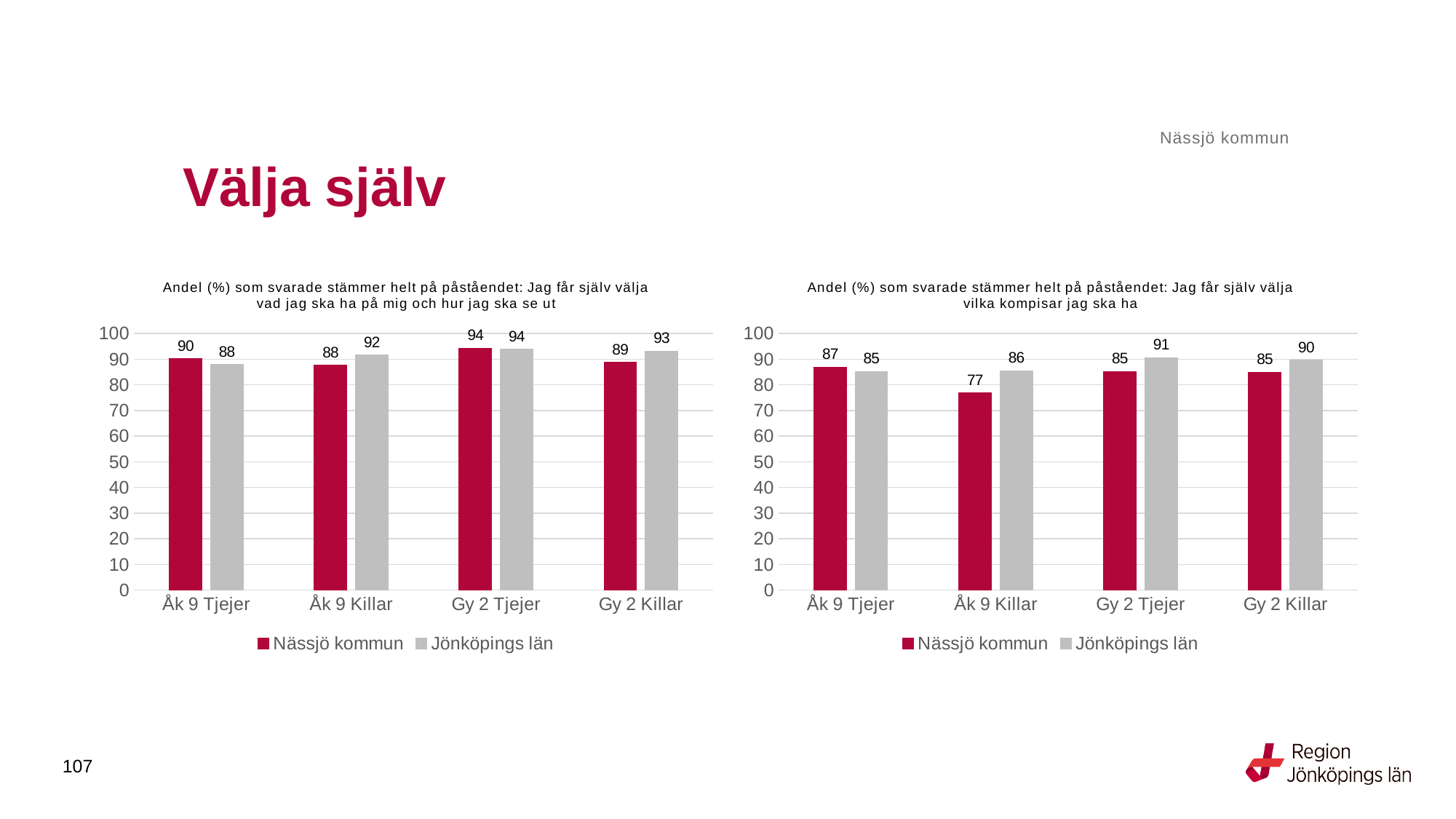
What type of chart is the right chart? Bar chart In the right chart, what is the value for Jönköpings län for Gy 2 Tjejer? 91 In the right chart, what is the value for Nässjö kommun for Åk 9 Killar? 77 In the left chart, which is larger for Åk 9 Tjejer: Nässjö kommun or Jönköpings län? Nässjö kommun In the right chart, what is the difference between Jönköpings län and Nässjö kommun for Åk 9 Killar? 9 In the left chart, what is the value for Nässjö kommun for Åk 9 Tjejer? 90 In the left chart, which category has the highest value for Nässjö kommun? Gy 2 Tjejer In the left chart, what is the difference between Jönköpings län and Nässjö kommun for Åk 9 Killar? 4 How many categories are shown on the x axis of the right chart? 4 In the left chart, what is the value for Jönköpings län for Gy 2 Killar? 93 In the right chart, which category has the lowest value for Nässjö kommun? Åk 9 Killar How many series does the legend of the left chart list? 2